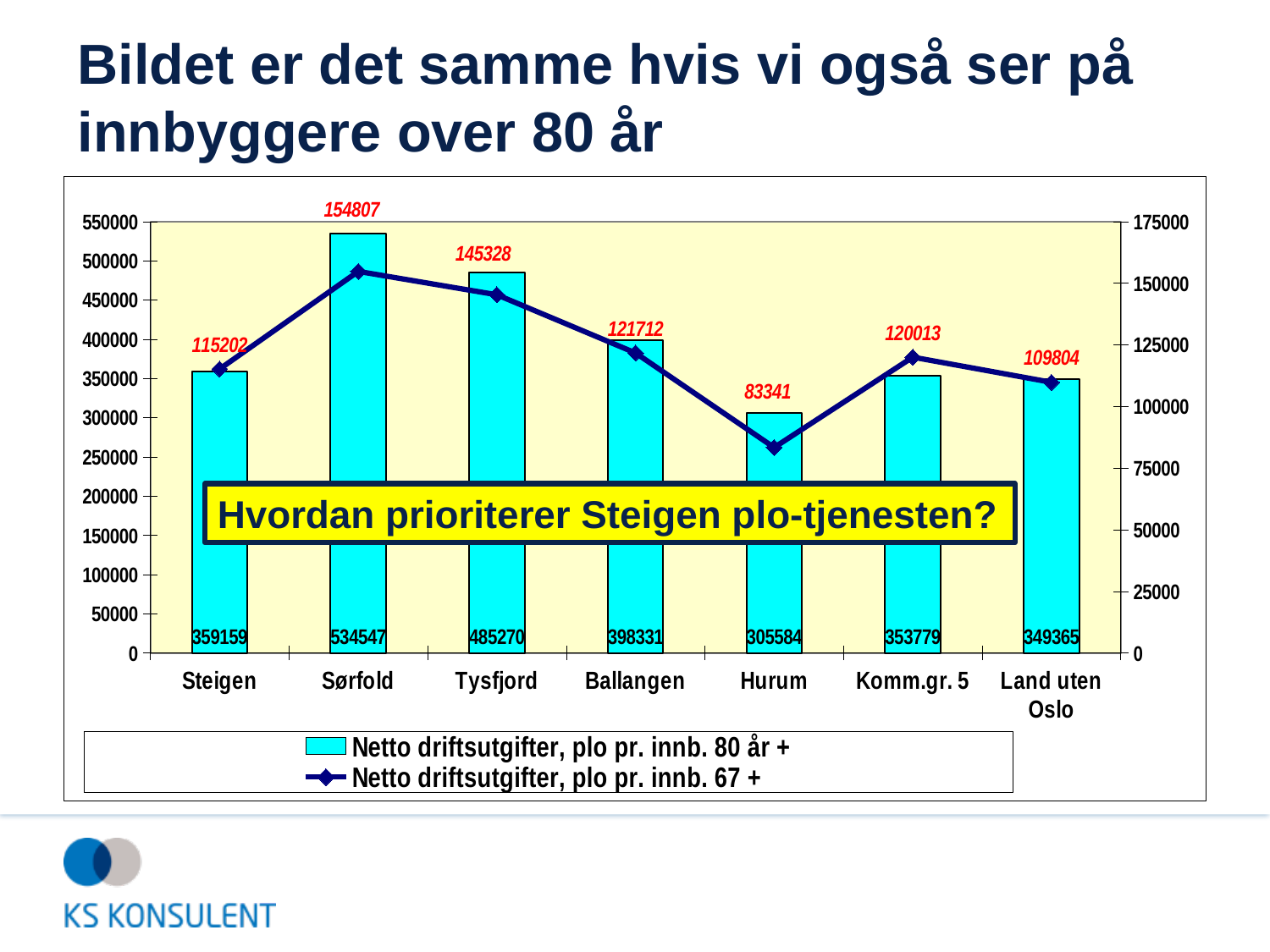
What is the difference between Sørfold and Tysfjord for 'Netto driftsutgifter, plo pr. innb. 80 år +'? 49277 Which category has the highest value for 'Netto driftsutgifter, plo pr. innb. 80 år +'? Sørfold What is the value of 'Netto driftsutgifter, plo pr. innb. 80 år +' for Steigen? 359159 Is the value of 'Netto driftsutgifter, plo pr. innb. 80 år +' for Hurum greater or less than 350000? less Which category has the lowest value for 'Netto driftsutgifter, plo pr. innb. 67 +'? Hurum What is the value of 'Netto driftsutgifter, plo pr. innb. 67 +' for Hurum? 83341 What is the value of 'Netto driftsutgifter, plo pr. innb. 80 år +' for Land uten Oslo? 349365 How many series does the legend list? 2 What kind of chart is used for the series 'Netto driftsutgifter, plo pr. innb. 80 år +'? bar chart What text is shown in the yellow box overlaid on the chart? Hvordan prioriterer Steigen plo-tjenesten? Which is larger for 'Netto driftsutgifter, plo pr. innb. 67 +': Ballangen or Komm.gr. 5? Ballangen How many categories are shown on the x axis? 7